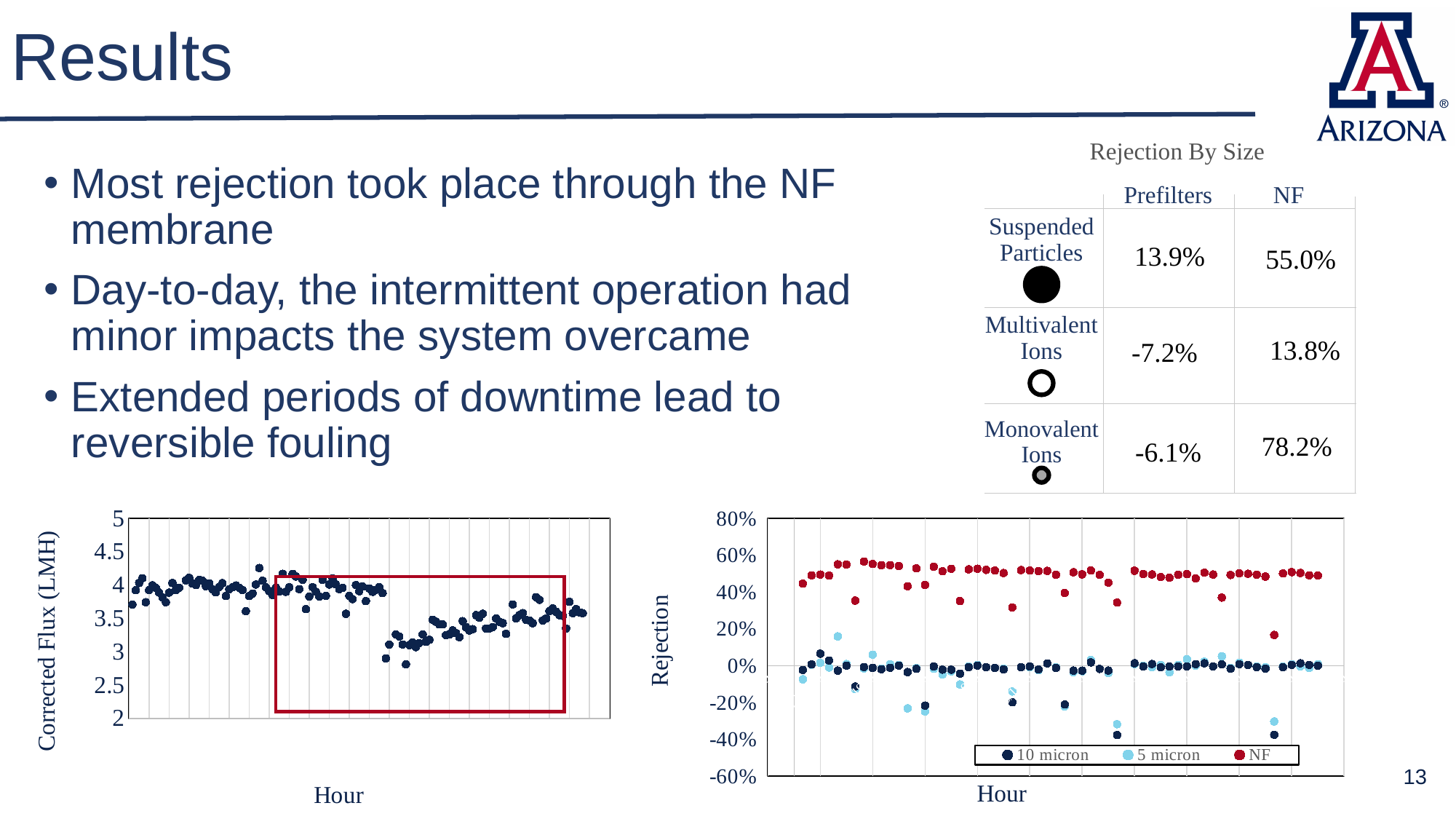
On the left chart, is the highest plotted point greater or less than 4? greater On the right chart, which series has higher rejection values, NF or 10 micron? NF On the right chart, are the NF series values mostly greater or less than 40%? greater What is the maximum value shown on the y axis of the left chart? 5 On the left chart, is the lowest plotted point greater or less than 3? less What kind of chart is the right chart with the y axis labelled Rejection? scatter chart What is the x-axis label of the left chart? Hour How many series does the legend of the right chart (Rejection vs Hour) list? 3 What is the y-axis label of the left chart? Corrected Flux (LMH) On the left chart, do the corrected flux values generally rise or fall along the x axis? fall On the right chart, which series has the highest rejection values? NF What kind of chart is the left chart with the y axis labelled Corrected Flux (LMH)? scatter chart